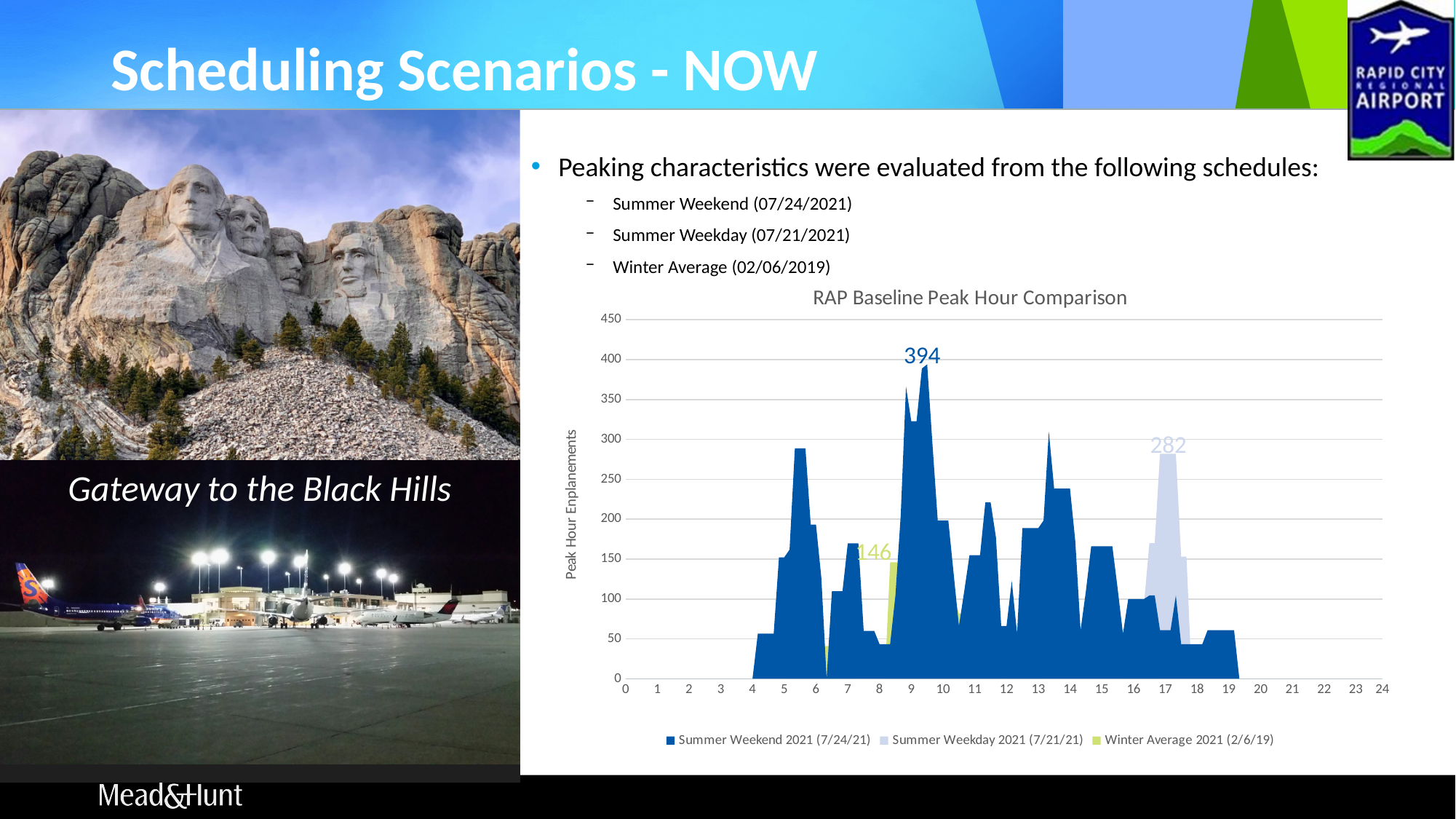
What is the labeled peak value for the Winter Average 2021 (2/6/19) series? 146 Which series has the highest labeled peak value in the chart? Summer Weekend 2021 (7/24/21) What is the title of the chart on the slide? RAP Baseline Peak Hour Comparison How many series does the legend of the RAP Baseline Peak Hour Comparison chart list? 3 What is the difference between the Summer Weekday peak (282) and the Winter Average peak (146)? 136 What is the labeled peak value for the Summer Weekend 2021 (7/24/21) series? 394 What is the difference between the Summer Weekend peak (394) and the Summer Weekday peak (282)? 112 What is the labeled peak value for the Summer Weekday 2021 (7/21/21) series? 282 Which series has the lowest labeled peak value in the chart? Winter Average 2021 (2/6/19) Is the Winter Average peak value greater or less than 150? less What kind of chart is the RAP Baseline Peak Hour Comparison chart? area chart What is the label on the vertical axis of the chart? Peak Hour Enplanements